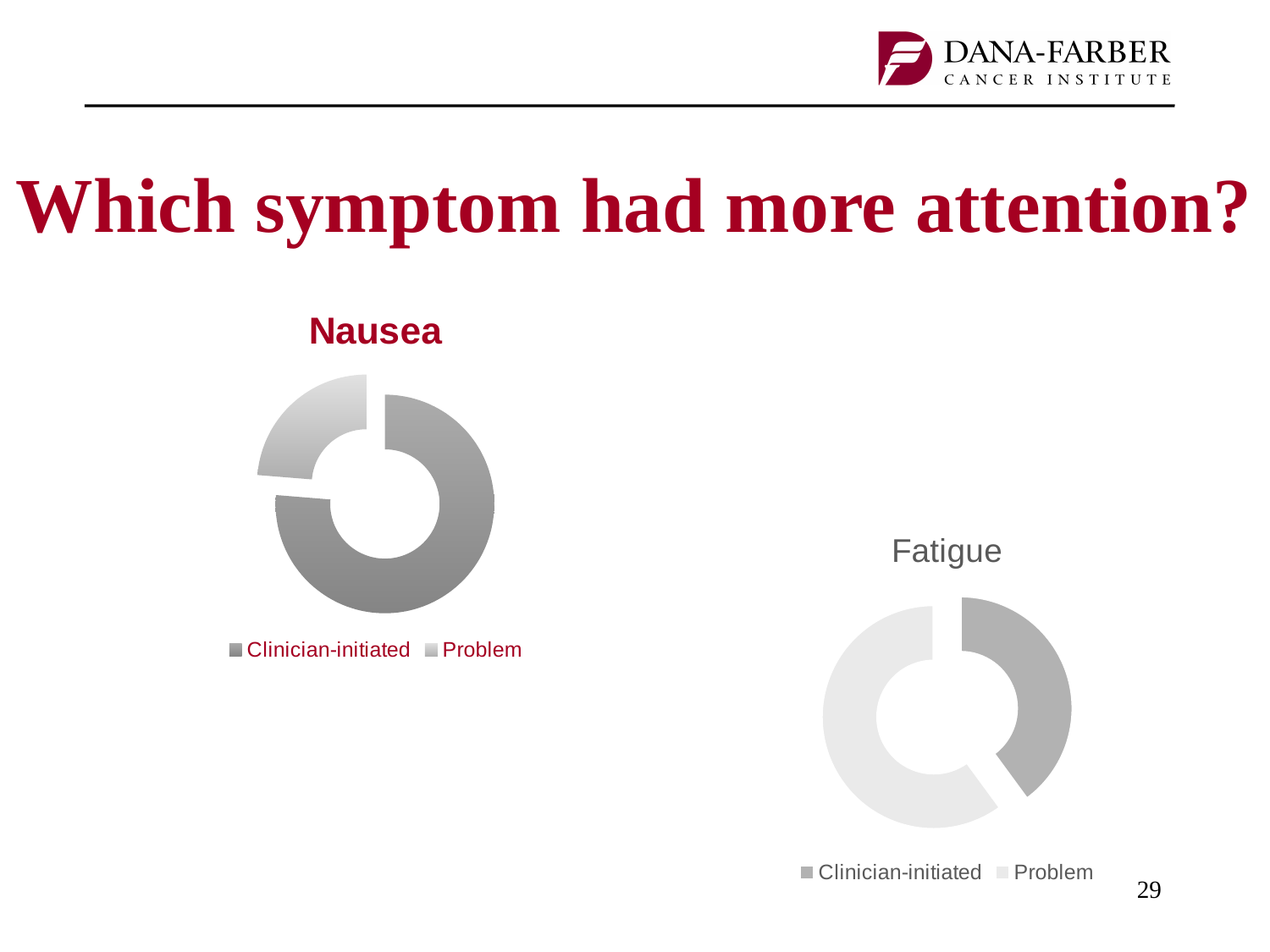
What kind of chart is the Nausea chart? doughnut chart How many slices does the Fatigue chart have? 2 In the Fatigue chart, which category has the largest slice? Problem In the Nausea chart, which category has the smallest slice? Problem In the Nausea chart, how many entries does the legend list? 2 In the Fatigue chart, how many entries does the legend list? 2 In the Nausea chart, which slice is larger, Clinician-initiated or Problem? Clinician-initiated What are the two legend entries in the Fatigue chart? Clinician-initiated and Problem What is the title of the chart on the left side of the slide? Nausea In the Fatigue chart, which slice is larger, Clinician-initiated or Problem? Problem What kind of chart is the Fatigue chart? doughnut chart How many slices does the Nausea chart have? 2